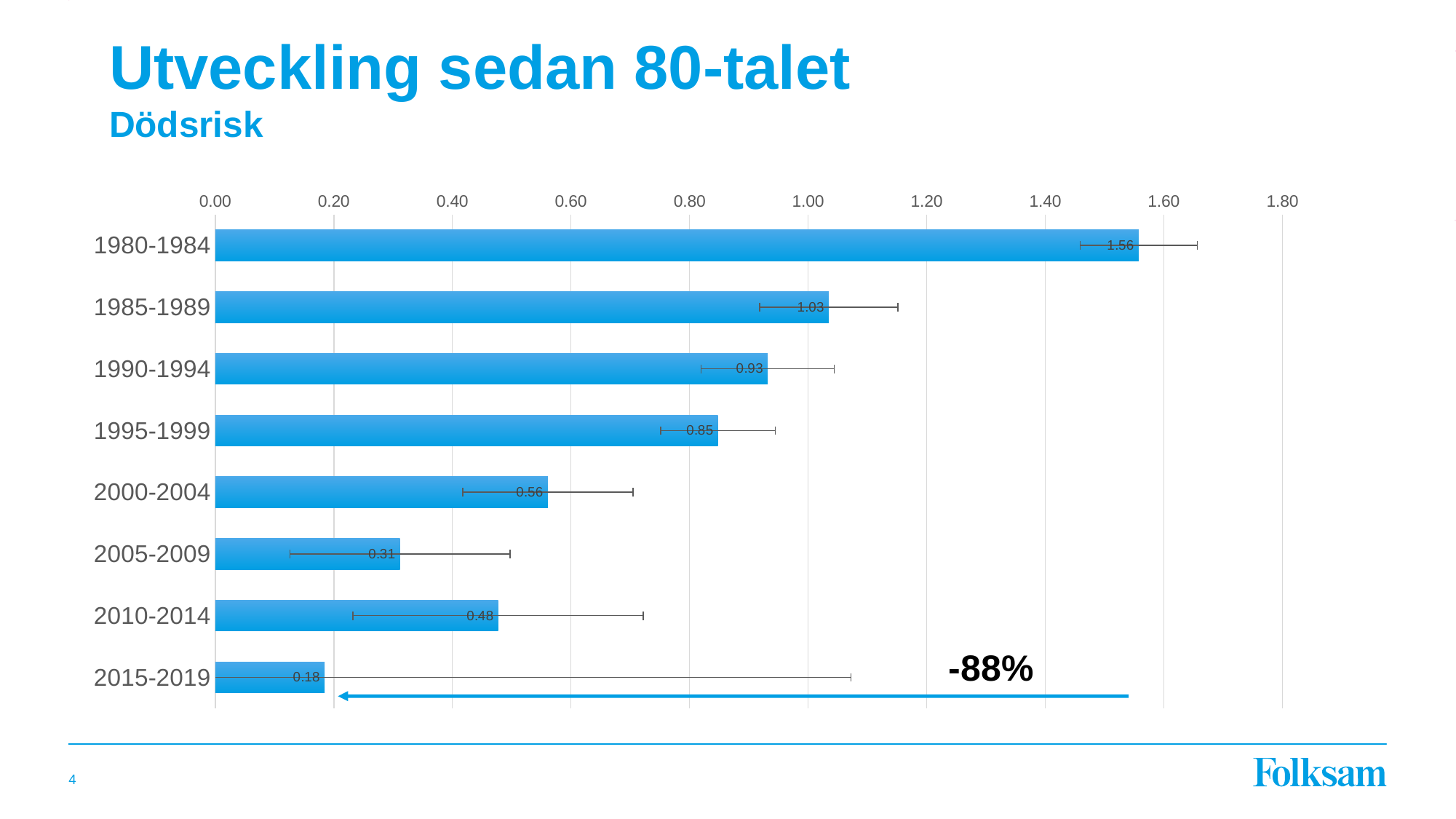
Which is larger, the value for 2005-2009 or the value for 2010-2014? 2010-2014 What is the value for 2015-2019? 0.18 What percentage change is annotated next to the arrow at the bottom of the chart? -88% What is the value for 2010-2014? 0.48 What is the value for 2000-2004? 0.56 What is the difference between the values for 1985-1989 and 1990-1994? 0.10 What is the value for 1980-1984? 1.56 Which period has the highest value? 1980-1984 Which period has the lowest value? 2015-2019 How many periods are shown in the chart? 8 What kind of chart is shown on the slide? bar chart Is the value for 1995-1999 greater or less than 0.80? greater